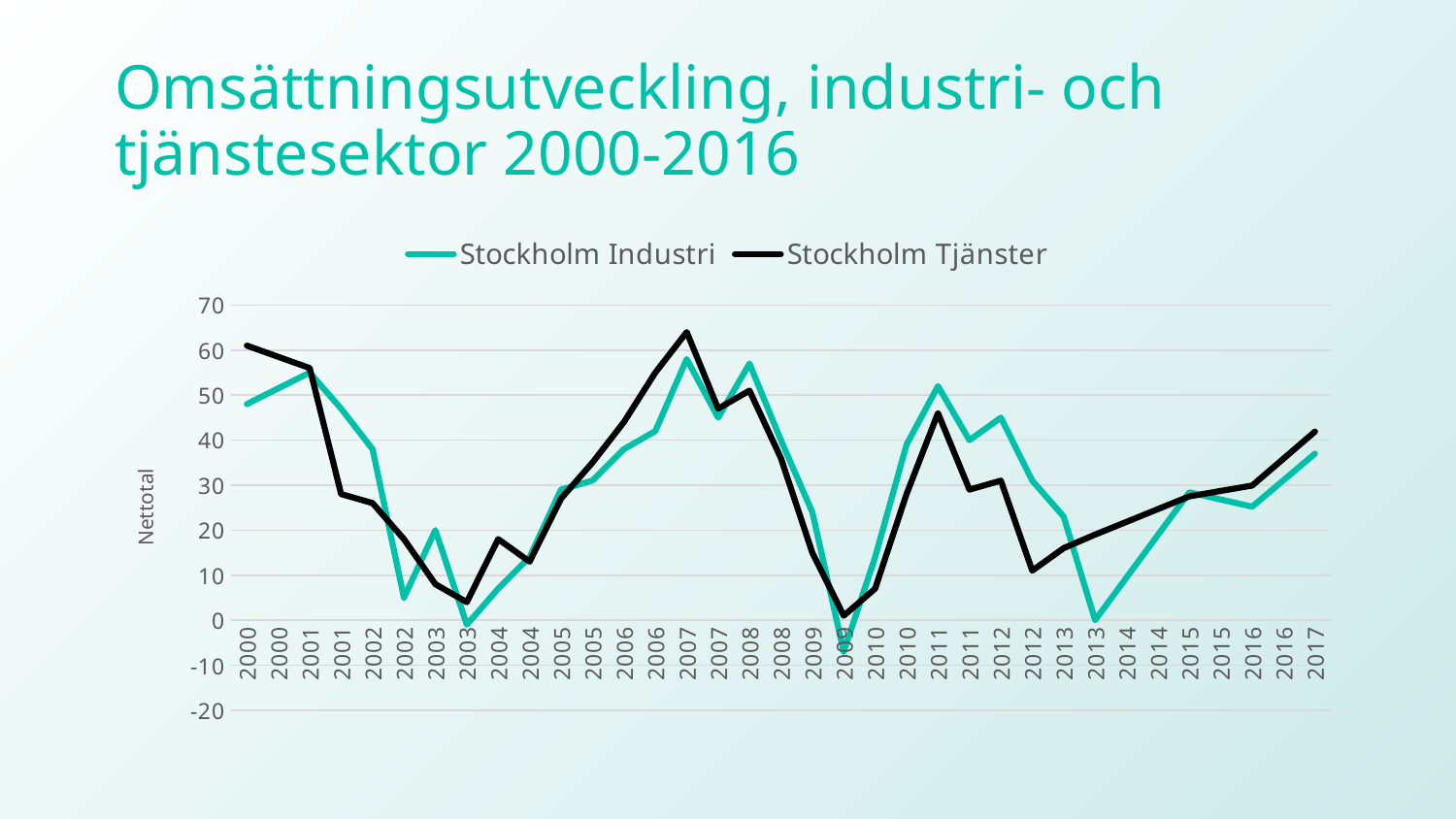
How many data points are plotted along the x axis for each series? 35 What kind of chart is shown on the slide? line chart Is the value for Stockholm Industri at the second 2013 point greater or less than 10? less At the second 2012 point, which series has the higher value, Stockholm Industri or Stockholm Tjänster? Stockholm Industri At 2017, which series has the higher value, Stockholm Industri or Stockholm Tjänster? Stockholm Tjänster How many series does the legend list? 2 Does the Stockholm Tjänster line rise or fall from the second 2013 point to 2017? rise Is the value for Stockholm Industri at the first 2000 point greater or less than 60? less What is the label on the vertical axis? Nettotal Is the value for Stockholm Tjänster at the first 2000 point greater or less than 50? greater What is the title of the chart? Omsättningsutveckling, industri- och tjänstesektor 2000-2016